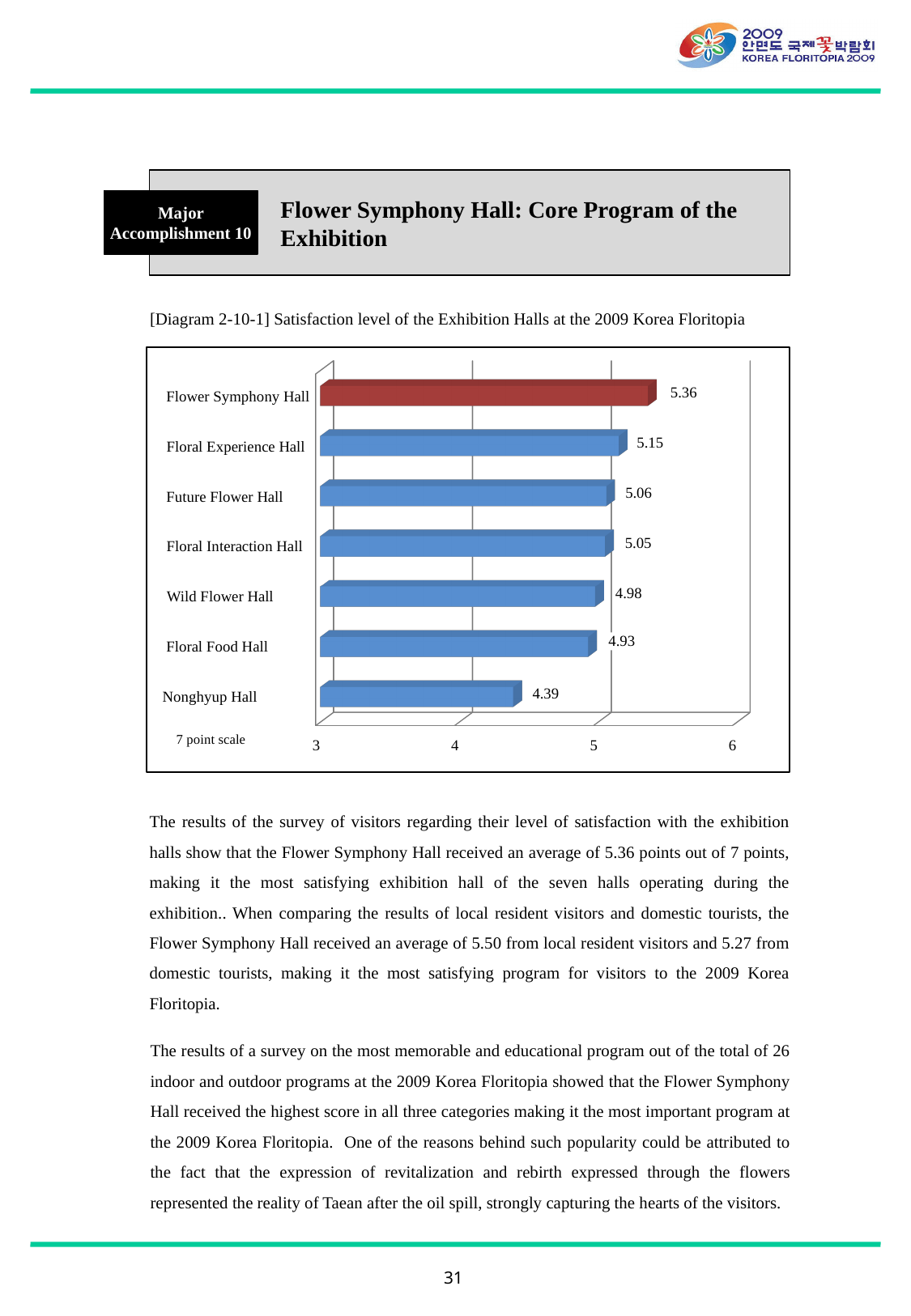
How many exhibition halls are shown in the chart? 7 Which exhibition hall has the highest satisfaction score? Flower Symphony Hall What kind of chart is shown on the slide? Bar chart What is the satisfaction score for Wild Flower Hall? 4.98 Which exhibition hall has the lowest satisfaction score? Nonghyup Hall What is the difference between the scores of Flower Symphony Hall and Nonghyup Hall? 0.97 What is the difference between the scores of Floral Experience Hall and Floral Food Hall? 0.22 Is the value for Wild Flower Hall greater or less than 5? less Which bar in the chart is coloured differently (red) from the others? Flower Symphony Hall Which has a higher score, Future Flower Hall or Floral Food Hall? Future Flower Hall What is the satisfaction score for Flower Symphony Hall? 5.36 What is the satisfaction score for Nonghyup Hall? 4.39